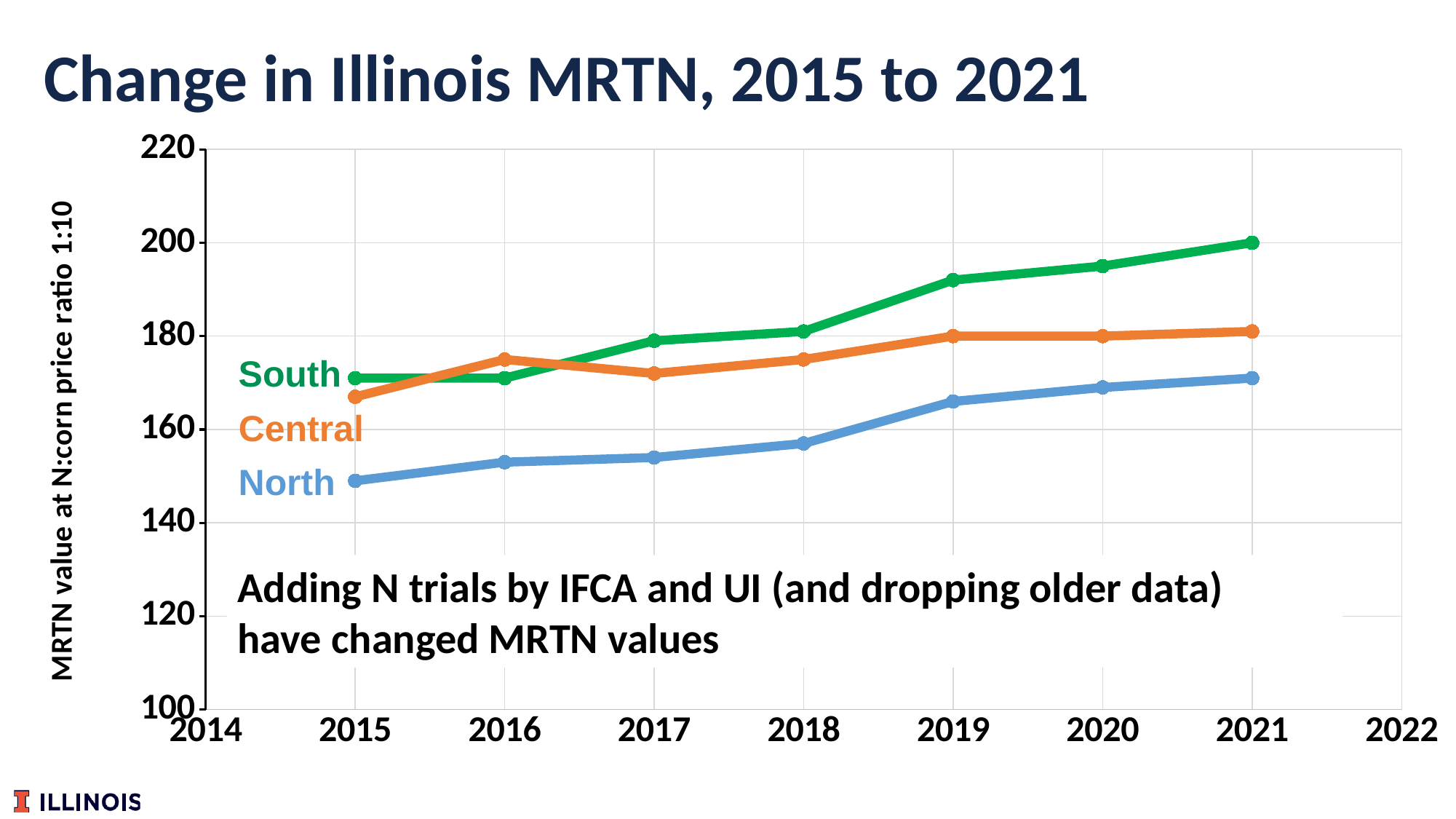
Is the MRTN value for North in 2015 greater or less than 160? less Which region has the highest MRTN value in 2021? South What kind of chart is shown on the slide? line chart What is the title of the chart? Change in Illinois MRTN, 2015 to 2021 Is the MRTN value for North in 2021 greater or less than 180? less In 2016, which region has the larger MRTN value, Central or South? Central Does the MRTN value for North rise or fall from 2015 to 2021? rise Which region has the lowest MRTN value in 2021? North Is the MRTN value for Central in 2015 greater or less than 160? greater How many years of data points are plotted for each region? 7 How many series (regions) are plotted on the chart? 3